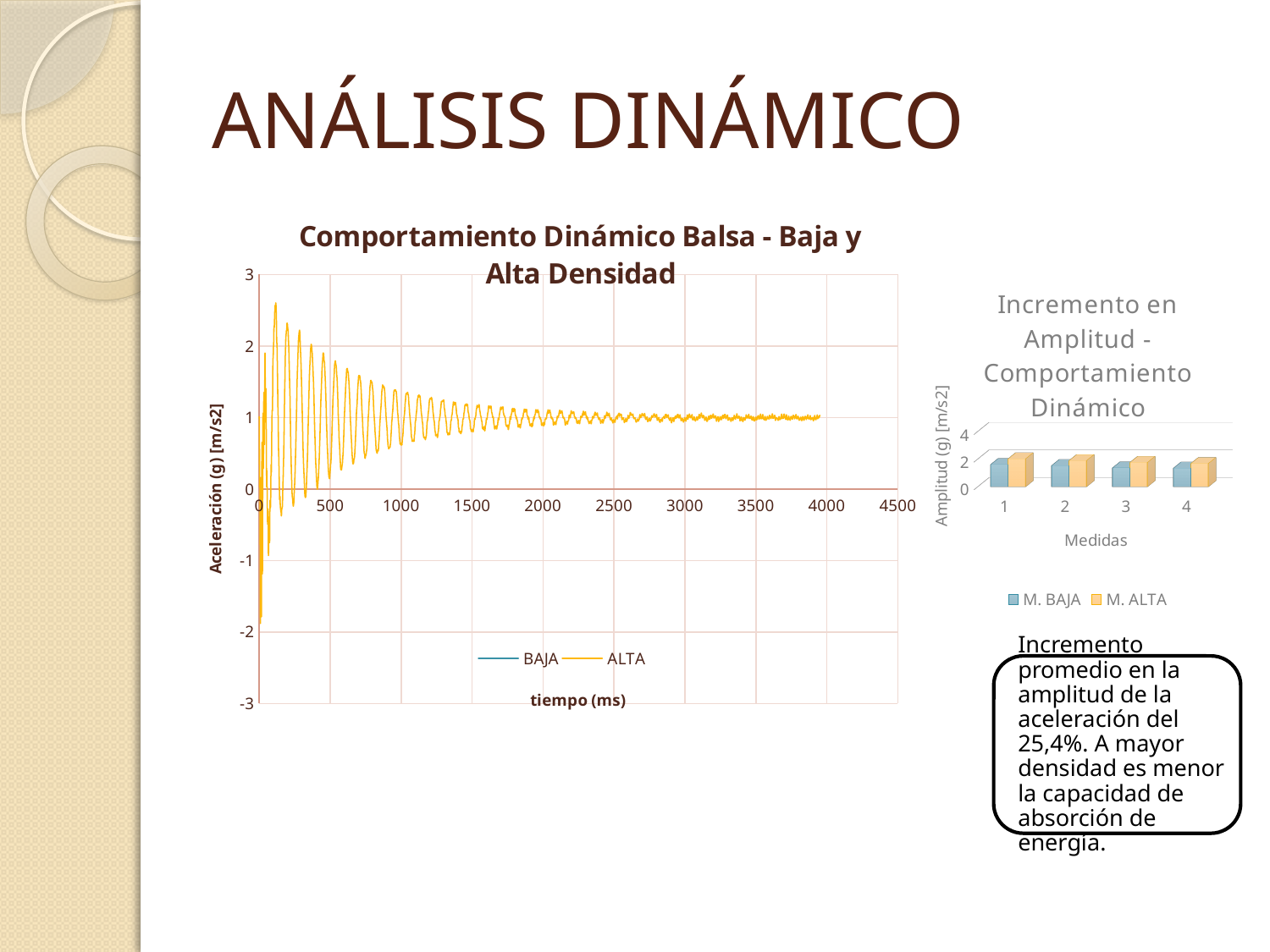
In the 'Comportamiento Dinámico Balsa - Baja y Alta Densidad' chart, is the value of the ALTA series at 3500 ms greater or less than 2? less What kind of chart is the 'Comportamiento Dinámico Balsa - Baja y Alta Densidad' chart? line chart In the 'Comportamiento Dinámico Balsa - Baja y Alta Densidad' chart, does the amplitude of the oscillation increase or decrease as time increases? decrease In the 'Incremento en Amplitud - Comportamiento Dinámico' chart, which series has the larger value for Medida 1, M. BAJA or M. ALTA? M. ALTA What is the x-axis title of the 'Incremento en Amplitud - Comportamiento Dinámico' chart? Medidas What are the legend entries of the 'Comportamiento Dinámico Balsa - Baja y Alta Densidad' chart? BAJA and ALTA How many series does the legend of the 'Incremento en Amplitud - Comportamiento Dinámico' chart list? 2 How many categories (Medidas) are shown on the x axis of the 'Incremento en Amplitud - Comportamiento Dinámico' chart? 4 In the 'Incremento en Amplitud - Comportamiento Dinámico' chart, is the M. BAJA value for Medida 4 greater or less than 2? less What kind of chart is the 'Incremento en Amplitud - Comportamiento Dinámico' chart? bar chart In the 'Comportamiento Dinámico Balsa - Baja y Alta Densidad' chart, is the highest peak of the ALTA series greater or less than 2? greater How many series does the legend of the 'Comportamiento Dinámico Balsa - Baja y Alta Densidad' chart list? 2